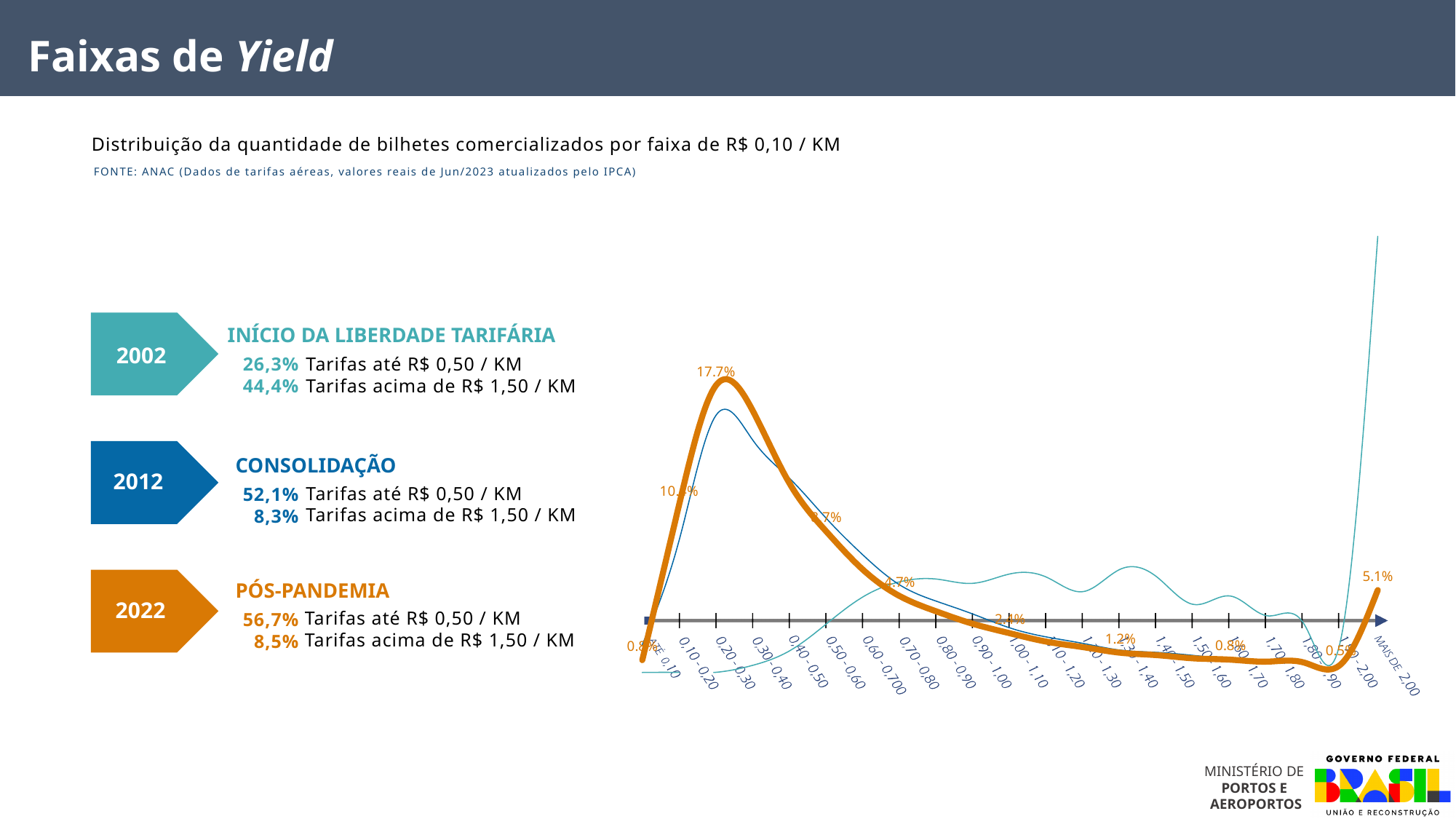
What is the value labelled on the 2022 (orange) line for the 'Até 0,10' band? 0.8% What is the lowest value labelled on the 2022 (orange) line? 0.5% What is the highest value labelled on the 2022 (orange) line? 17.7% At the peak around the 0,20-0,30 band, which line is higher: 2022 (orange) or 2012 (blue)? 2022 How many lines (series) are plotted on the chart? 3 What is the first category label on the x axis of the chart? Até 0,10 What is the value labelled on the 2022 (orange) line for the 'Mais de 2,00' band? 5.1% What kind of chart is shown on the slide? line chart Does the 2022 (orange) line rise or fall from the 0,20-0,30 band to the 1,80-1,90 band? fall What is the difference between the peak value of the 2022 line (17.7%) and its value for 'Mais de 2,00' (5.1%)? 12.6% How many yield bands (categories) are shown along the x axis of the chart? 21 Which series has the highest value in the 'Mais de 2,00' band? 2002